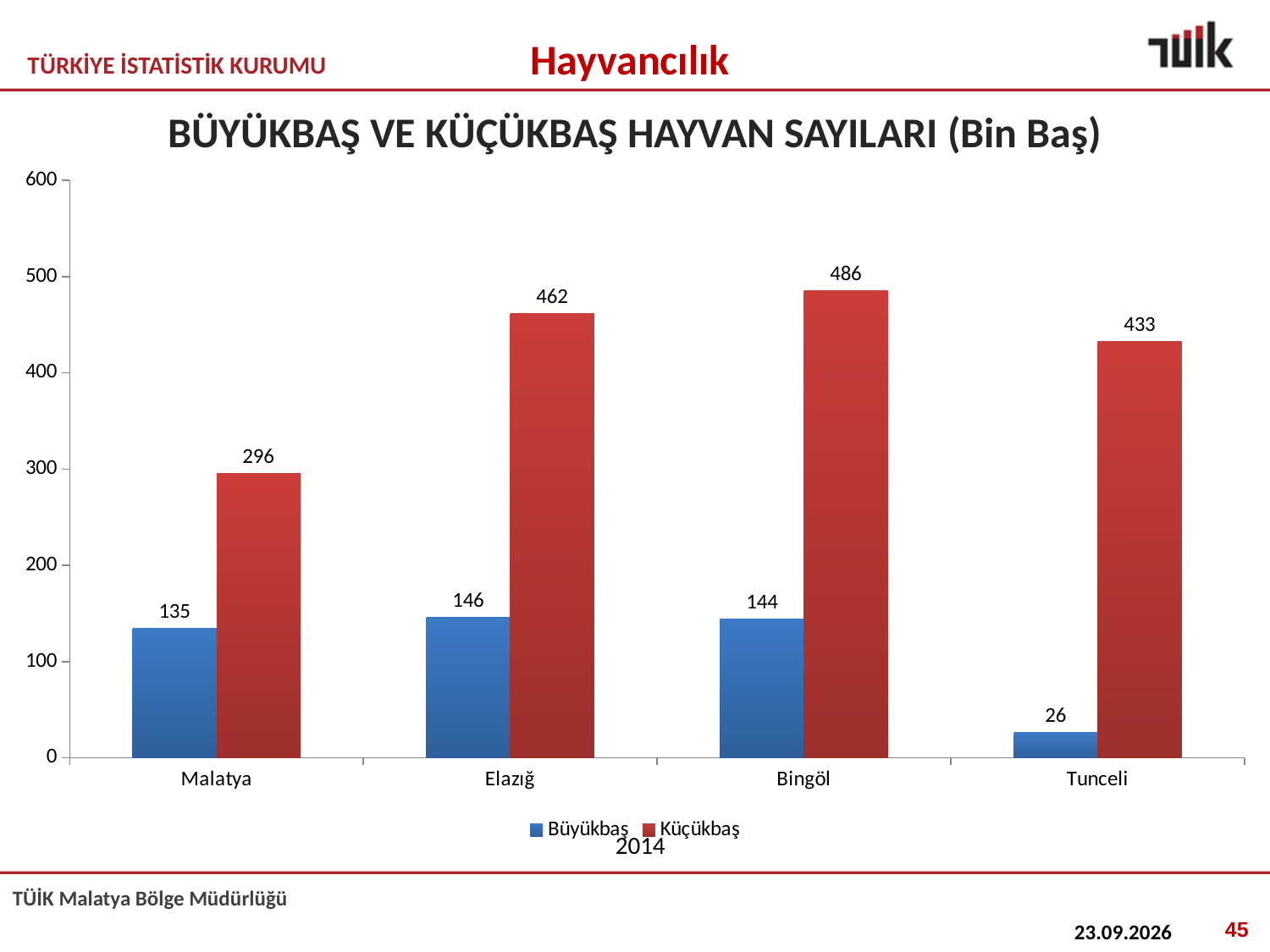
What is the Büyükbaş value for Malatya? 135 How many series does the legend list? 2 How many provinces are shown on the x axis? 4 What is the Küçükbaş value for Bingöl? 486 What kind of chart is shown on the slide? bar chart What is the difference between the Küçükbaş and Büyükbaş values for Elazığ? 316 Which province has the highest Küçükbaş value? Bingöl What is the Büyükbaş value for Tunceli? 26 What colour are the Küçükbaş bars? red Which is larger, the Küçükbaş value for Elazığ or for Tunceli? Elazığ Which province has the lowest Büyükbaş value? Tunceli Is the Küçükbaş value for Malatya greater or less than 400? less